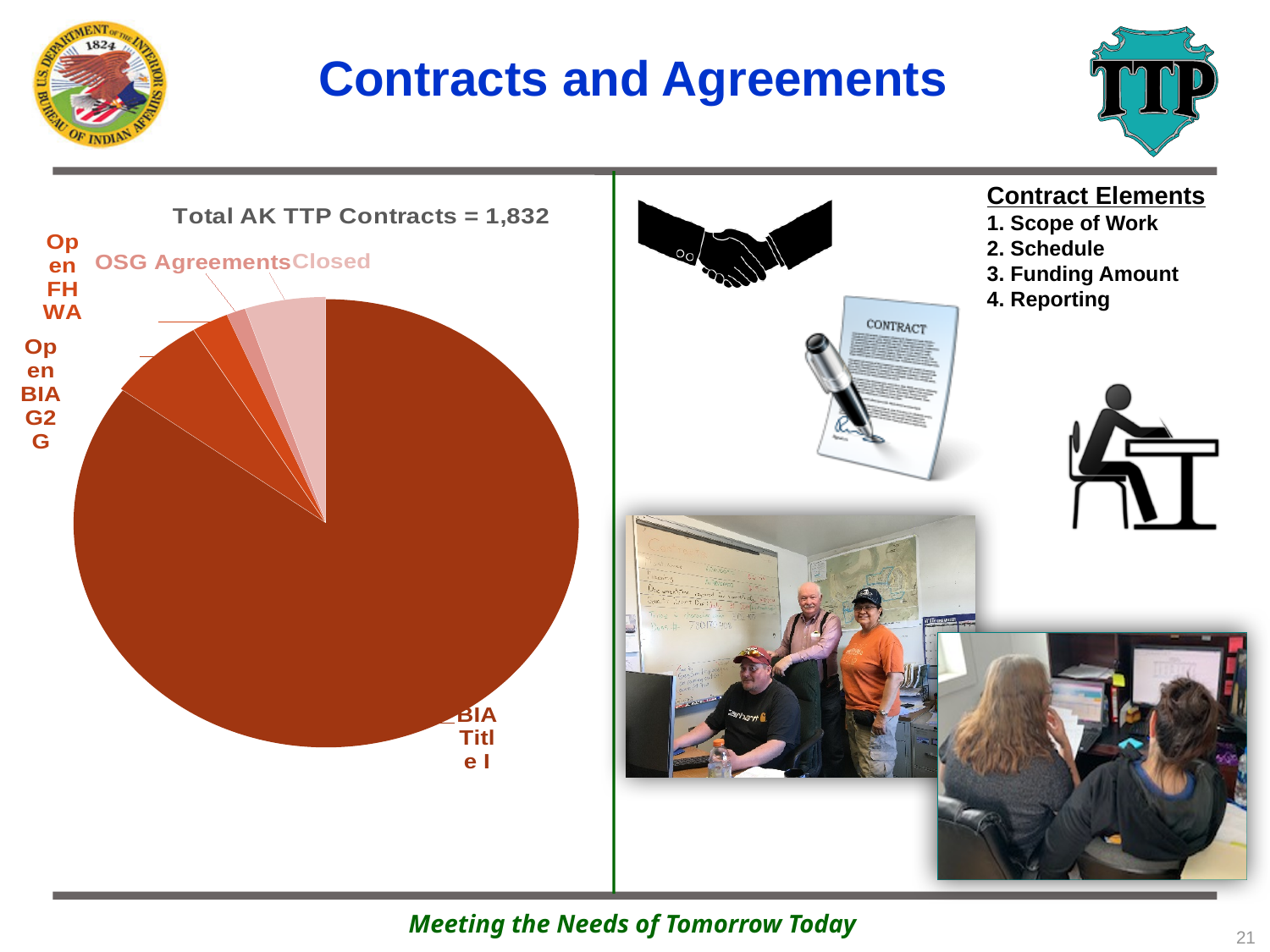
What is the title of the pie chart? Total AK TTP Contracts = 1,832 Which slice is larger, BIA Title I or OSG Agreements? BIA Title I According to the chart title, what is the total number of AK TTP contracts? 1,832 Does the BIA Title I slice make up more or less than half of the pie chart? More Which slice is larger, Open BIA G2G or BIA Title I? BIA Title I Which slice is larger, BIA Title I or Closed? BIA Title I What kind of chart is shown on the slide? Pie chart Which category has the largest slice of the pie chart? BIA Title I Which category is labelled at the bottom right of the pie chart? BIA Title I How many categories are shown in the pie chart? 5